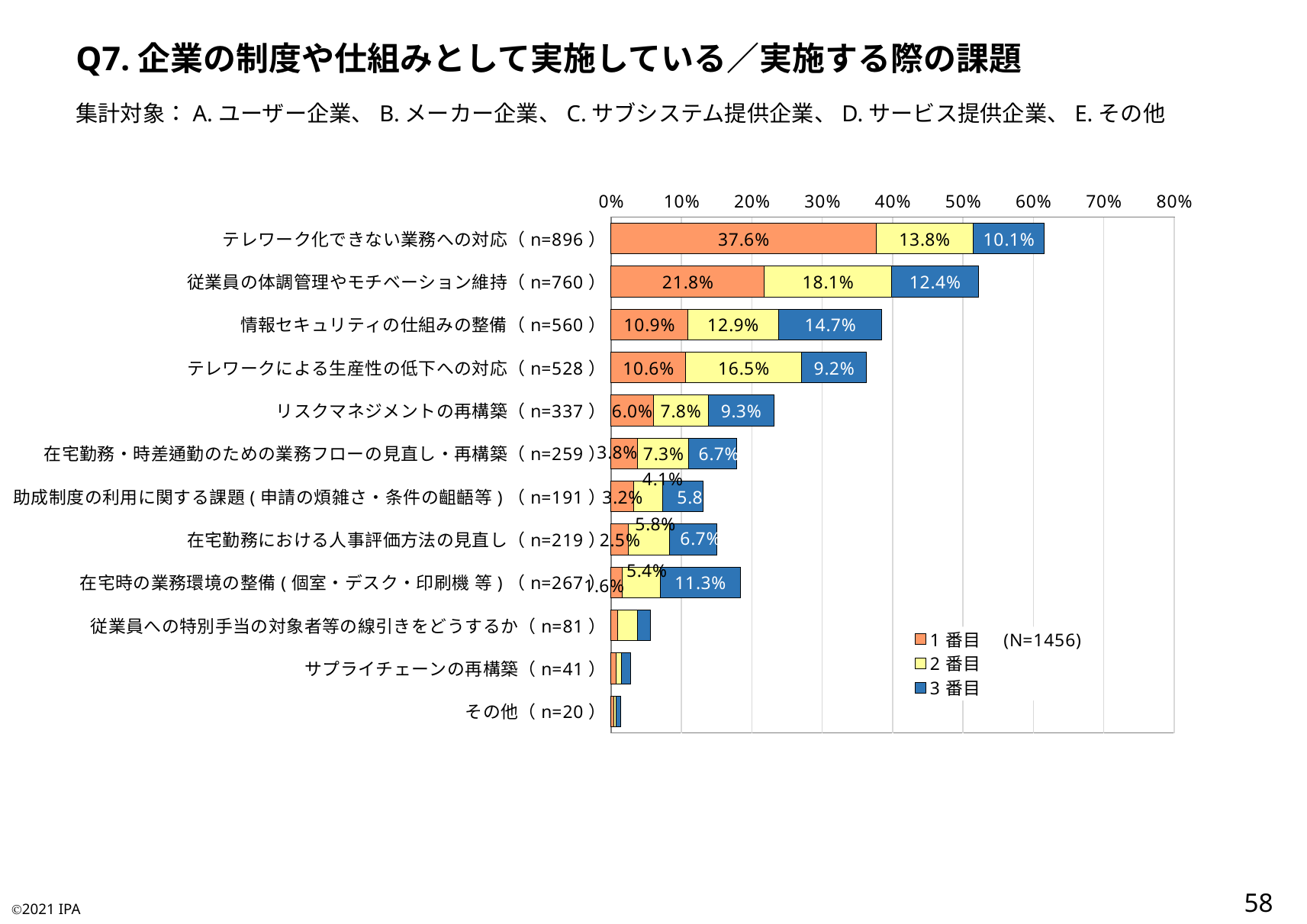
How many categories are shown on the chart? 12 What is the 1番目 value for テレワーク化できない業務への対応（n=896）? 37.6% What is the total of the stacked bar for リスクマネジメントの再構築（n=337）? 23.1% How many series does the legend list? 3 What is the total of the stacked bar for テレワーク化できない業務への対応（n=896）? 61.5% Which category has the highest 1番目 value? テレワーク化できない業務への対応（n=896） Which is larger: the 2番目 value for テレワークによる生産性の低下への対応 or the 2番目 value for 情報セキュリティの仕組みの整備? テレワークによる生産性の低下への対応 What is the 2番目 value for 従業員の体調管理やモチベーション維持（n=760）? 18.1% Is the total stacked bar for 従業員の体調管理やモチベーション維持（n=760）greater or less than 50%? greater What is the difference between the 1番目 values for テレワーク化できない業務への対応 and 従業員の体調管理やモチベーション維持? 15.8 percentage points What is the 3番目 value for 情報セキュリティの仕組みの整備（n=560）? 14.7% What kind of chart is shown on the slide? Stacked horizontal bar chart